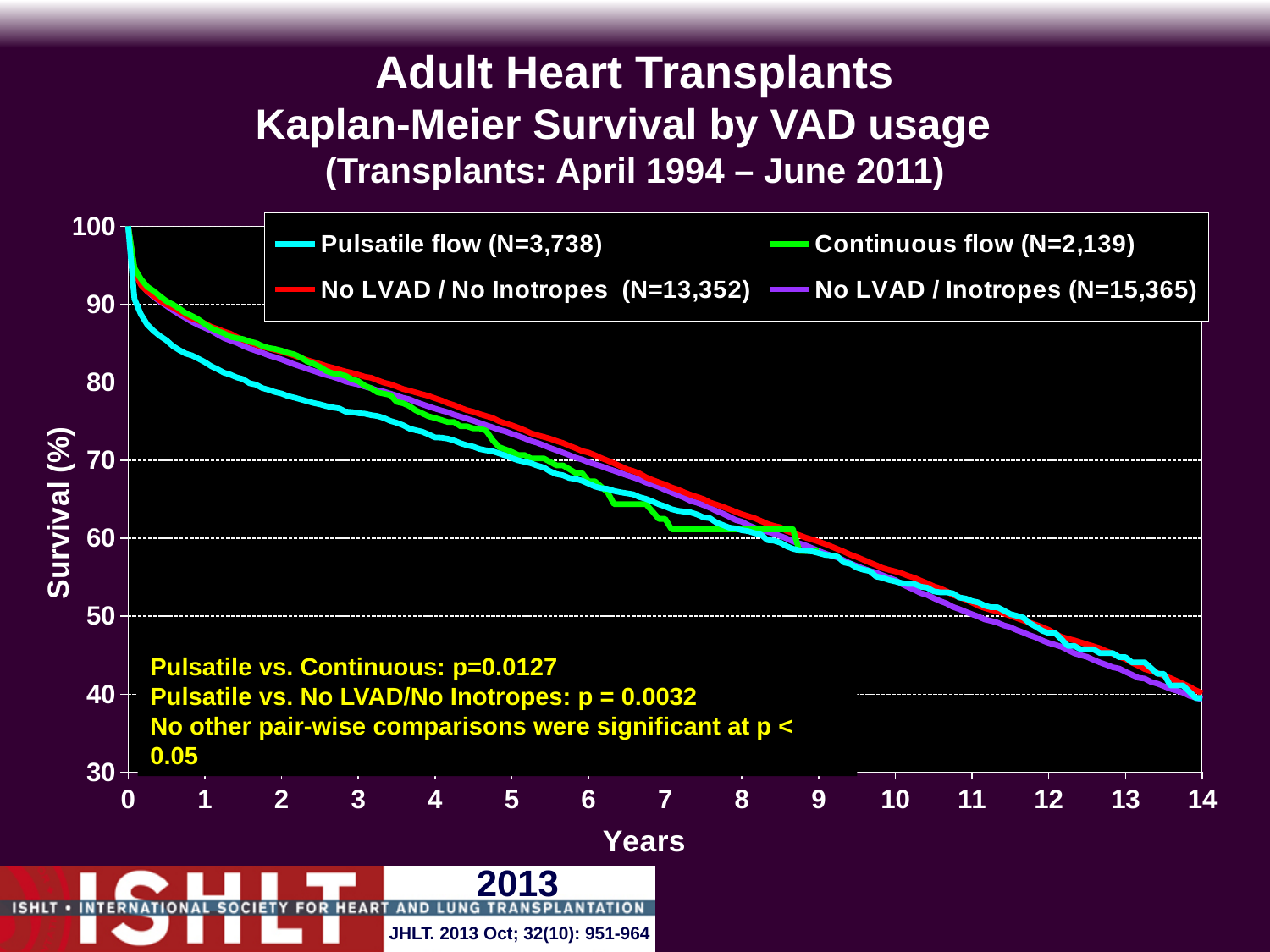
At year 2, is the survival for Continuous flow greater or less than 80? greater At year 1, which has higher survival: Pulsatile flow or Continuous flow? Continuous flow Do the survival curves rise or fall as years increase? fall How many series does the legend list? 4 What kind of chart is shown on the slide? line chart At year 10, is the survival for No LVAD / Inotropes greater or less than 60? less What is the N for the Pulsatile flow group shown in the legend? N=3,738 At year 2, which series has the lowest survival? Pulsatile flow At year 4, is the survival for No LVAD / No Inotropes greater or less than 80? less What p-value is given for Pulsatile vs. Continuous? p=0.0127